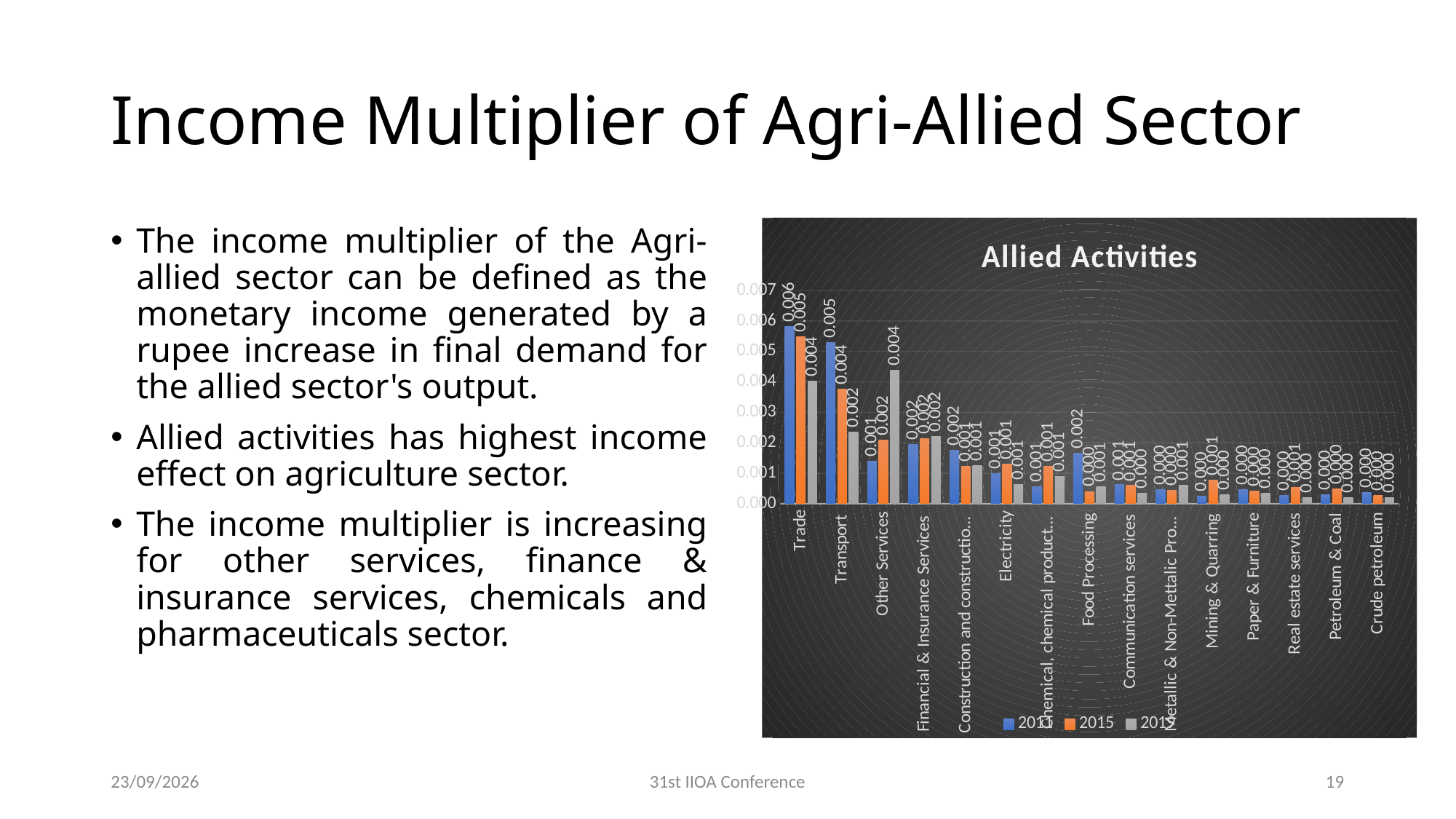
What kind of chart is shown on the slide? bar chart How many categories are shown on the x axis of the chart? 15 Is the blue bar for Trade greater or less than 0.005? greater Which category has the highest blue (first) bar? Trade How many series does the chart's legend list? 3 What is the 2015 (orange) value for Trade? 0.005 What is the 2015 (orange) value for Transport? 0.004 What is the title of the chart? Allied Activities What is the value of the gray (third) bar for Other Services? 0.004 What is the value of the blue (first) bar for Trade? 0.006 What is the difference between the blue bar (0.006) and the gray bar (0.004) for Trade? 0.002 Which is larger, the blue bar for Trade or the blue bar for Transport? Trade